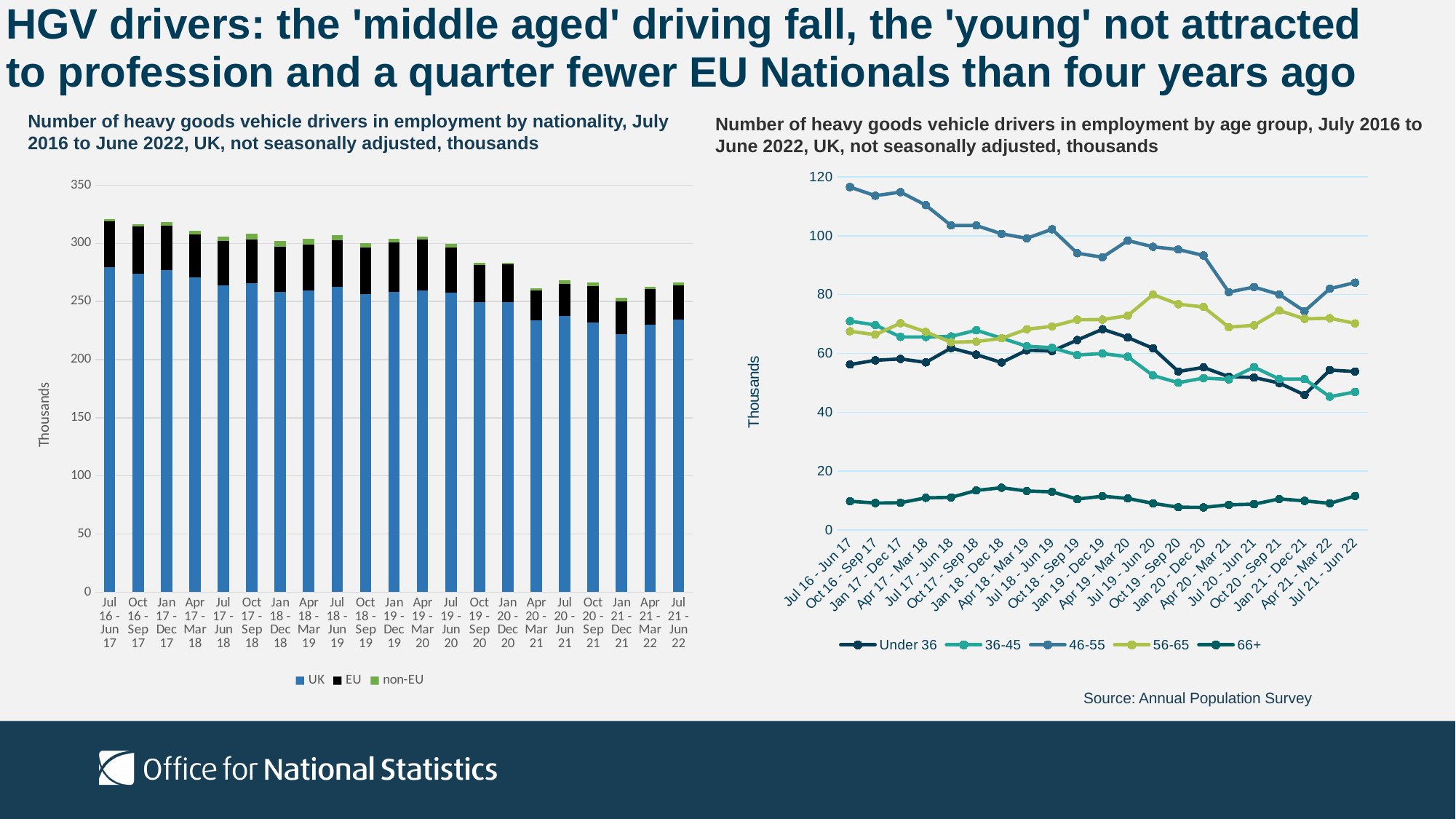
How many series does the legend of the left chart (by nationality) list? 3 How many series does the legend of the right chart (by age group) list? 5 In the right chart (by age group), which age group has the highest value in Jul 21 - Jun 22? 46-55 In the right chart (by age group), does the 46-55 series generally rise or fall from Jul 16 - Jun 17 to Jul 21 - Jun 22? fall In the left chart (by nationality), is the total height of the stacked bar for Jan 21 - Dec 21 greater or less than 300? less How many time periods are shown on the x axis of the left chart (by nationality)? 21 What type of chart is the left chart, 'Number of heavy goods vehicle drivers in employment by nationality'? bar chart In the right chart (by age group), which age group has the lowest values across the whole period? 66+ In the left chart (by nationality), is the UK value for Jul 16 - Jun 17 greater or less than 250? greater In the right chart (by age group), is the value for 46-55 in Jul 16 - Jun 17 greater or less than 100? greater What type of chart is the right chart, 'Number of heavy goods vehicle drivers in employment by age group'? line chart In the right chart (by age group), which is larger in Jul 16 - Jun 17: the value for 46-55 or the value for 56-65? 46-55